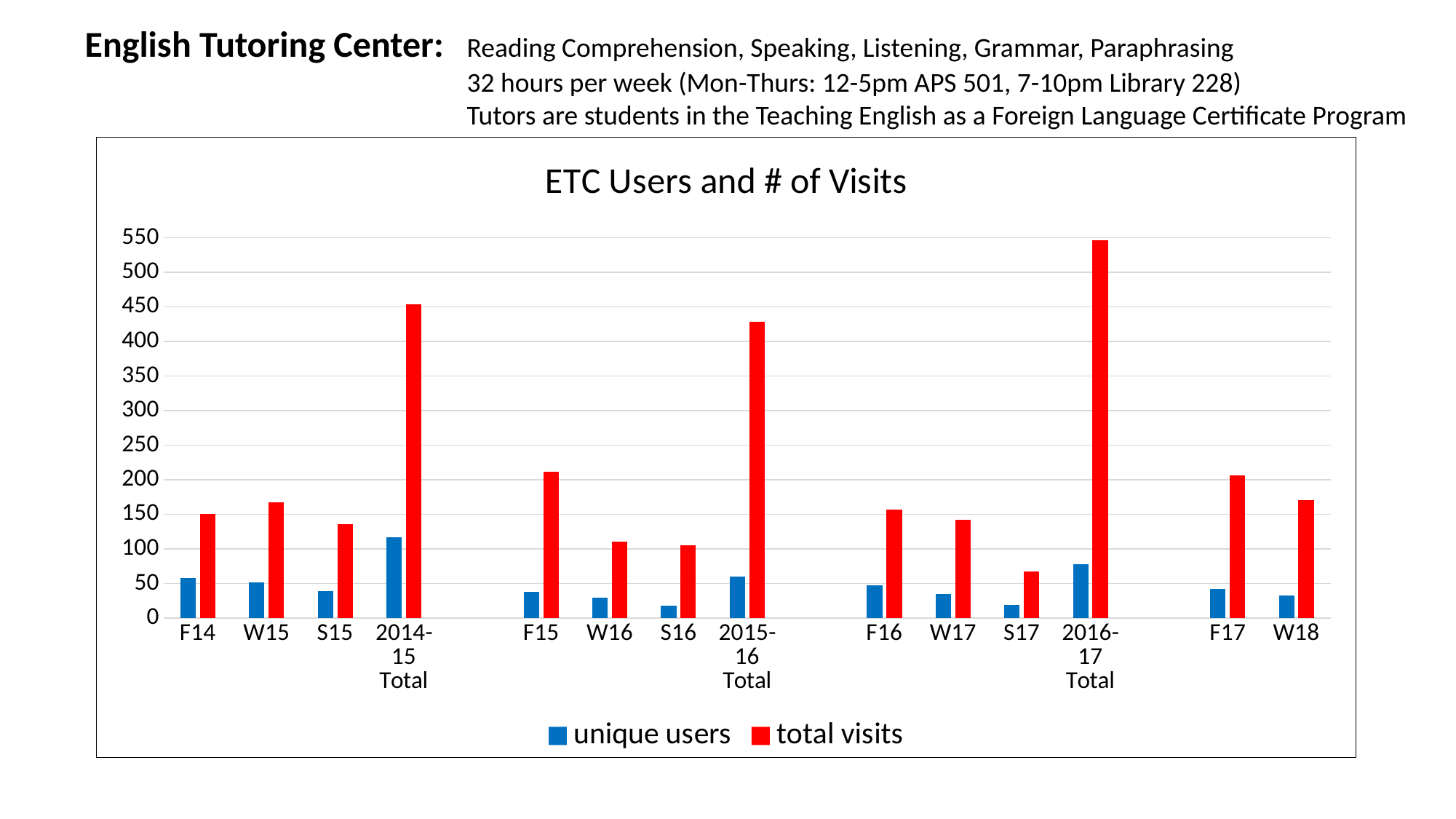
Is the total visits value for 2016-17 Total greater or less than 500? greater How many series does the legend list? 2 Which is larger, total visits for F15 or total visits for W16? F15 How many categories are shown on the x axis? 14 What kind of chart is shown on the slide? bar chart Do the unique users values rise or fall across F15, W16 and S16? fall Which category has the highest total visits? 2016-17 Total Which category has the lowest total visits? S17 Is the total visits value for 2015-16 Total greater or less than 450? less What is the title of the chart? ETC Users and # of Visits Which category has the highest number of unique users? 2014-15 Total Is the unique users value for 2014-15 Total greater or less than 100? greater